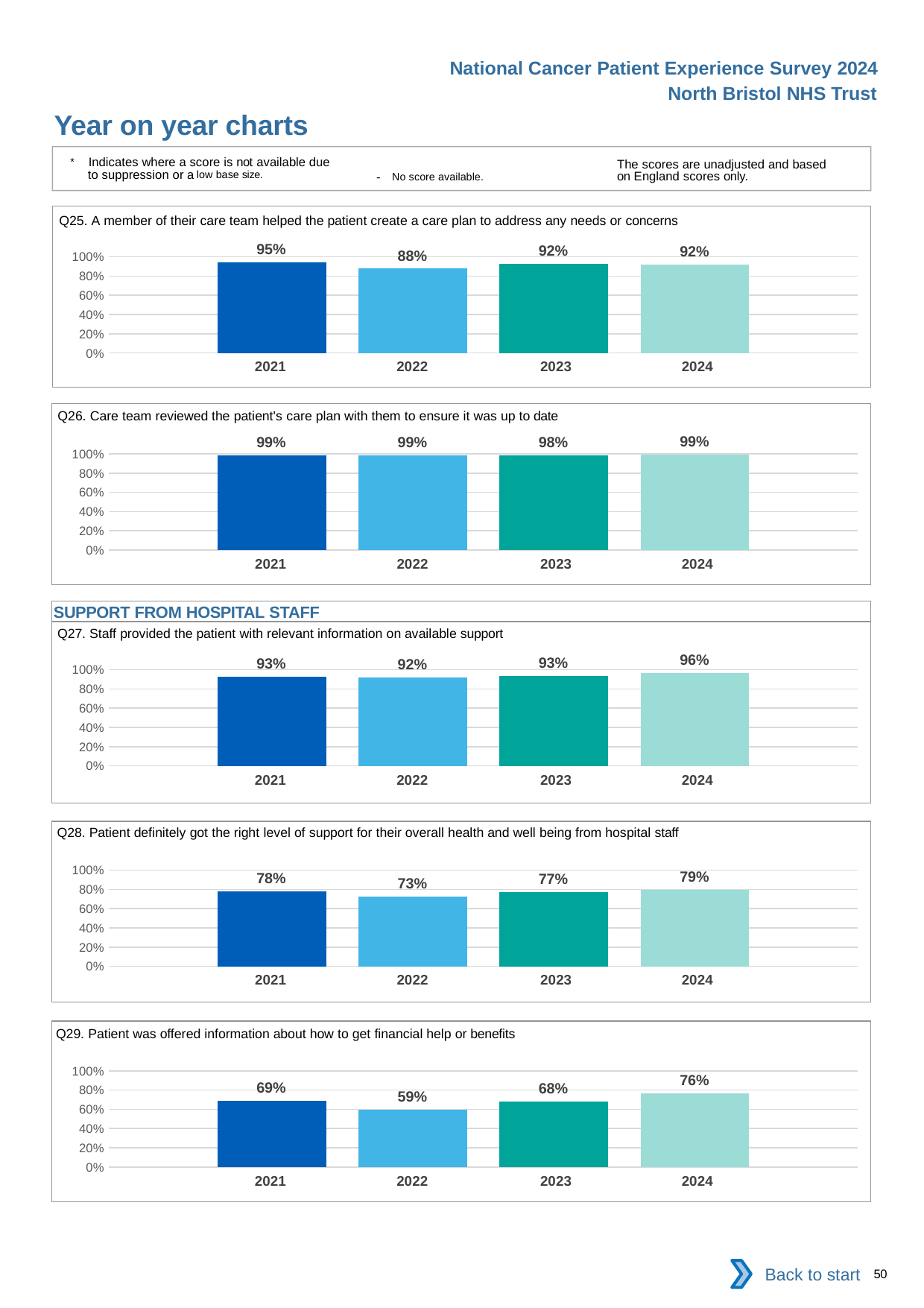
In the Q28 chart, which is larger, the value for 2021 or the value for 2023? 2021 In the Q27 chart, which year has the highest value? 2024 In the Q25 chart, which year has the lowest value? 2022 In the Q25 chart, what is the value for 2021? 95% In the Q29 chart, what is the difference between the 2021 and 2022 values? 10% In the Q29 chart, what is the value for 2024? 76% In the Q29 chart, is the value for 2022 greater or less than 80%? less What kind of chart is the Q26 chart? bar chart In the Q28 chart, what is the value for 2022? 73% How many years are shown in the Q28 chart? 4 In the Q27 chart, what is the difference between the 2024 and 2022 values? 4% In the Q26 chart, what is the value for 2023? 98%